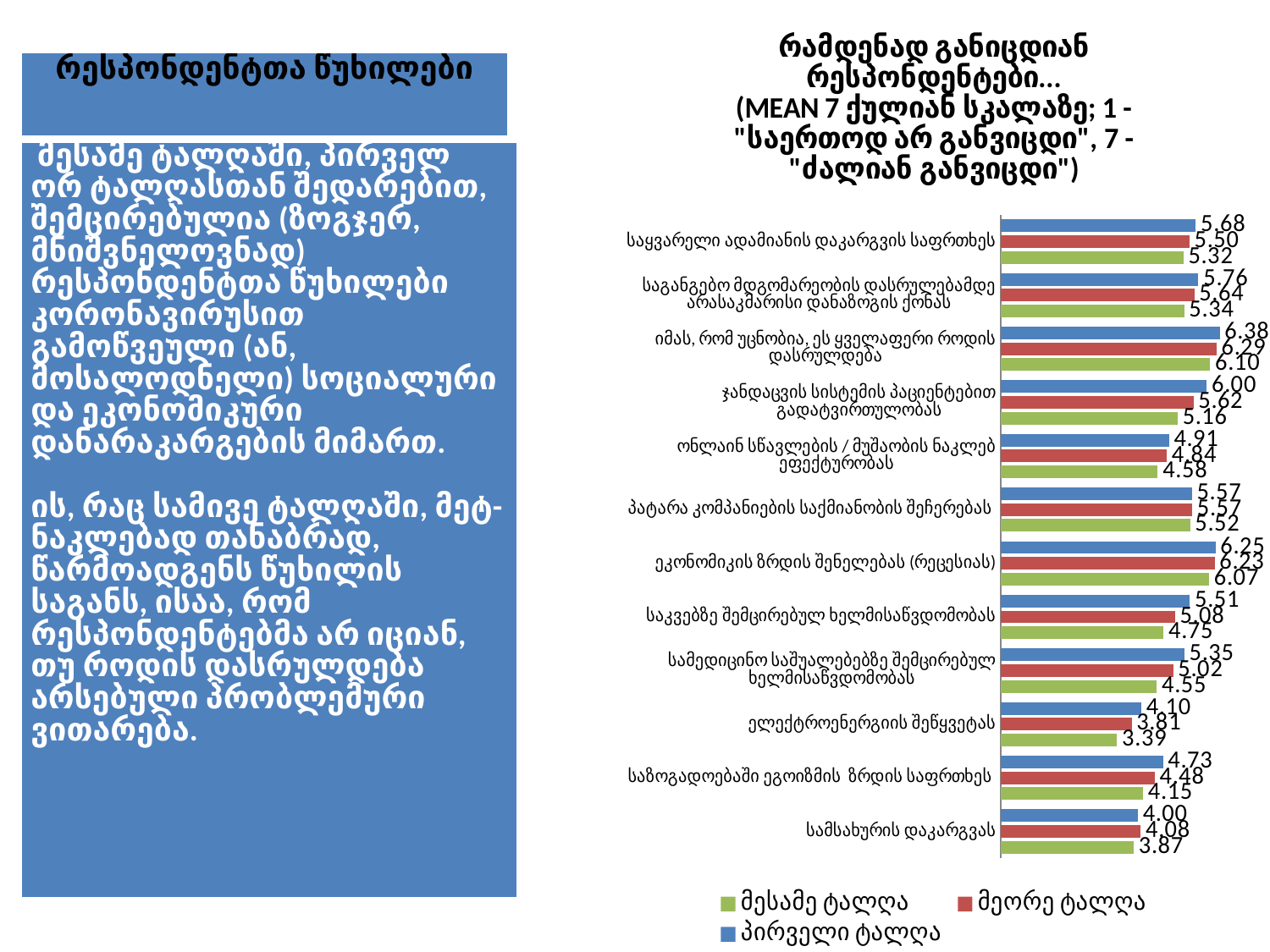
How many series does the chart legend list? 3 For the category "სამსახურის დაკარგვას", which is larger: the value for პირველი ტალღა or მეორე ტალღა? მეორე ტალღა Which colour represents the series მეორე ტალღა in the chart? red What is the value for პირველი ტალღა for the category "იმას, რომ უცნობია, ეს ყველაფერი როდის დასრულდება"? 6.38 What is the value for მეორე ტალღა for the category "სამსახურის დაკარგვას"? 4.08 What type of chart is shown on the slide? bar chart Which category has the lowest value for მესამე ტალღა? ელექტროენერგიის შეწყვეტას How many categories are plotted in the chart? 12 What is the value for მესამე ტალღა for the category "ელექტროენერგიის შეწყვეტას"? 3.39 What is the difference between the პირველი ტალღა and მესამე ტალღა values for "ჯანდაცვის სისტემის პაციენტებით გადატვირთულობას"? 0.84 Which category has the highest value for პირველი ტალღა? იმას, რომ უცნობია, ეს ყველაფერი როდის დასრულდება For the category "საკვებზე შემცირებულ ხელმისაწვდომობას", which is larger: the value for მეორე ტალღა or მესამე ტალღა? მეორე ტალღა